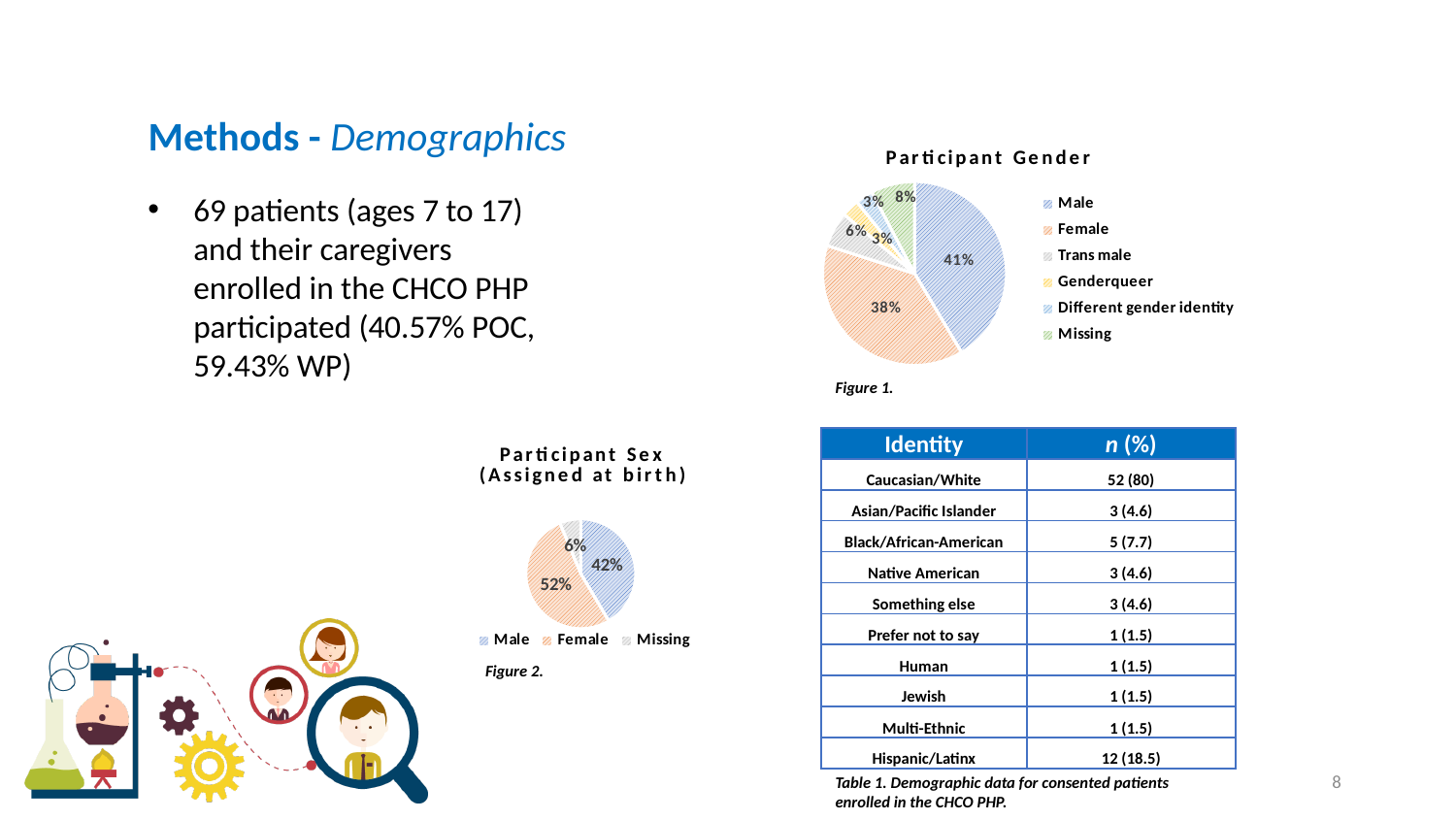
In the Participant Gender chart, what is the difference between the Male and Female shares? 3% In the Participant Gender chart, what percentage of participants are Female? 38% In the Participant Gender chart, how many categories does the legend list? 6 In the Participant Gender chart, what percentage of participants are Genderqueer? 3% In the Participant Gender chart, which gender category has the largest share? Male In the Participant Sex (Assigned at birth) chart, what percentage of participants are Female? 52% In the Participant Sex (Assigned at birth) chart, what percentage of participants are Male? 42% In the Participant Sex (Assigned at birth) chart, which category is larger, Male or Female? Female What type of chart is the Participant Sex (Assigned at birth) chart? Pie chart In the Participant Sex (Assigned at birth) chart, what percentage is Missing? 6% In the Participant Gender chart, what percentage is Missing? 8% In the Participant Gender chart, what percentage of participants are Male? 41%